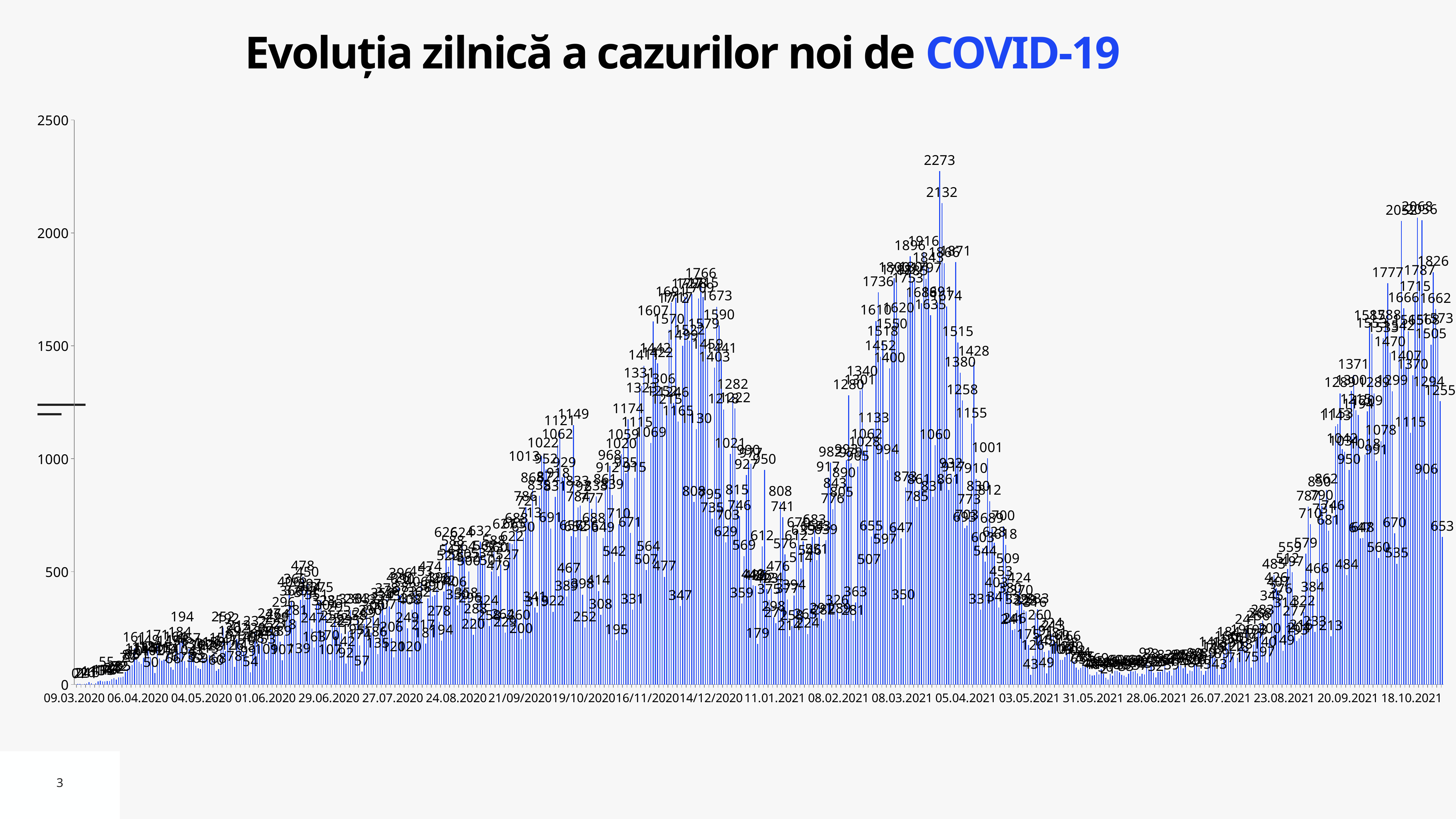
Is the highest bar near 18.10.2021 greater or less than 2000? greater What is the difference between the two highest labeled values, 2273 and 2132? 141 What is the difference between the peak value 2273 and the December 2020 peak value 1766? 507 Near which x-axis date label does the highest bar (2273) occur? 05.04.2021 Which is larger: the peak of the wave around 05.04.2021 (2273) or the peak of the wave around 14/12/2020 (1766)? 2273 (around 05.04.2021) What is the highest value shown on the y axis? 2500 Do the values rise or fall along the x axis between 26.07.2021 and 18.10.2021? rise What kind of chart is shown on the slide? bar chart Is the highest bar near 14/12/2020 greater or less than 2000? less What is the title of the chart? Evoluția zilnică a cazurilor noi de COVID-19 What is the highest value labeled on the chart? 2273 Are the bars near 31.05.2021 greater or less than 500? less